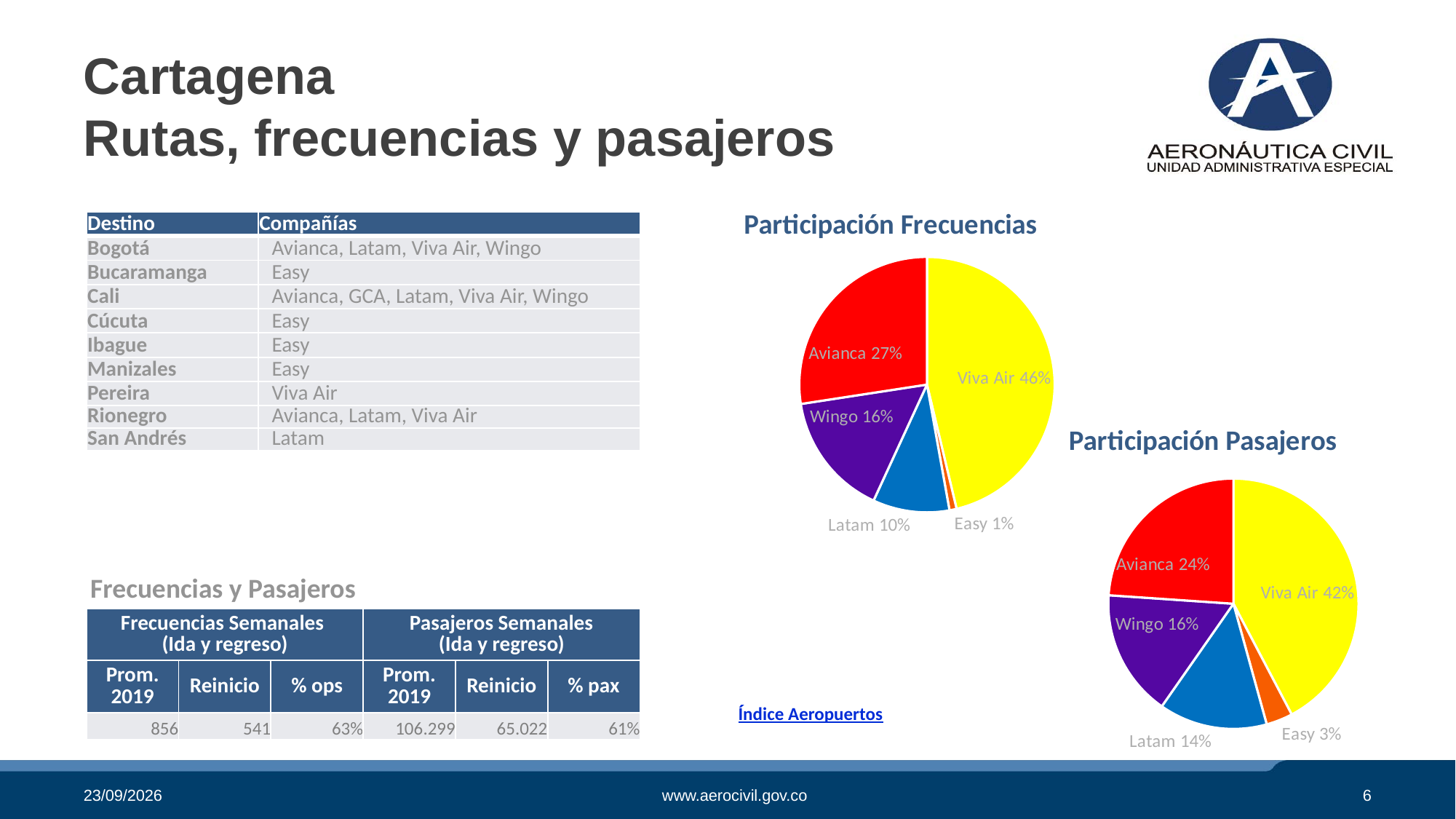
In the 'Participación Pasajeros' chart, what share does Easy have? 3% In the 'Participación Frecuencias' chart, what colour is the Wingo slice? Purple What type of chart is 'Participación Pasajeros'? Pie chart In the 'Participación Frecuencias' chart, what is the difference between the Viva Air and Avianca shares? 19 percentage points In the 'Participación Frecuencias' chart, how many slices are there? 5 In the 'Participación Pasajeros' chart, what share does Latam have? 14% In the 'Participación Pasajeros' chart, which airline has the largest share? Viva Air In the 'Participación Frecuencias' chart, what share does Avianca have? 27% In the 'Participación Frecuencias' chart, which airline has the largest share? Viva Air In the 'Participación Frecuencias' chart, what share does Viva Air have? 46% In the 'Participación Frecuencias' chart, which airline has the smallest share? Easy In the 'Participación Pasajeros' chart, which is larger, the Wingo share or the Latam share? Wingo